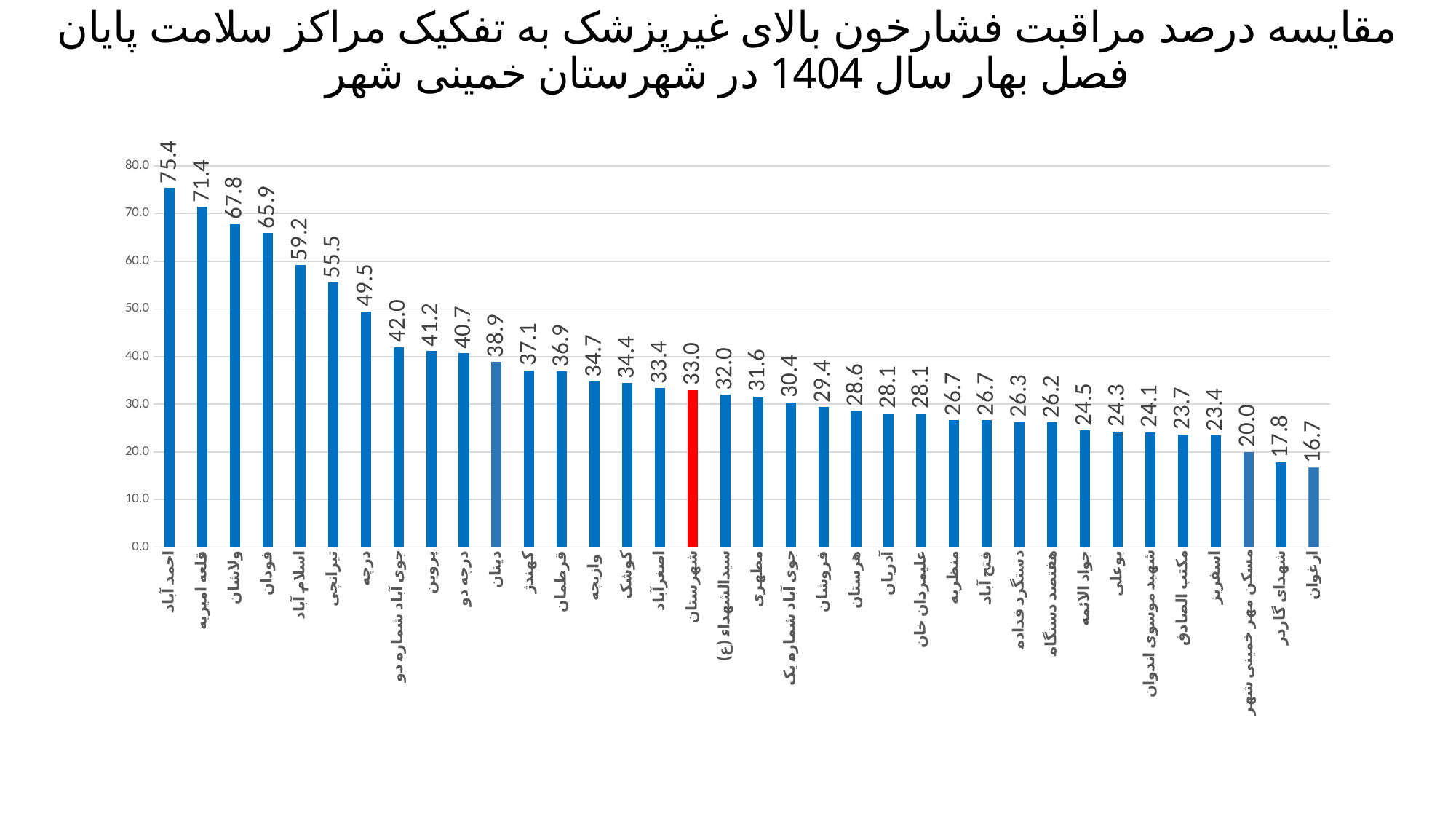
How many bars are plotted in the chart? 36 Which is larger, the value for تیرانچی or the value for دینان? تیرانچی What is the value for the red bar labelled شهرستان? 33.0 What is the value for مسکن مهر خمینی شهر? 20.0 Which category has the highest value? احمد آباد What is the value for درچه? 49.5 What type of chart is shown on the slide? bar chart Do the values rise or fall from left to right along the x axis? fall What is the difference between the values for قلعه امیریه and ولاشان? 3.6 Which category has the lowest value? ارغوان What is the difference between the values for احمد آباد and ارغوان? 58.7 What is the value for احمد آباد? 75.4